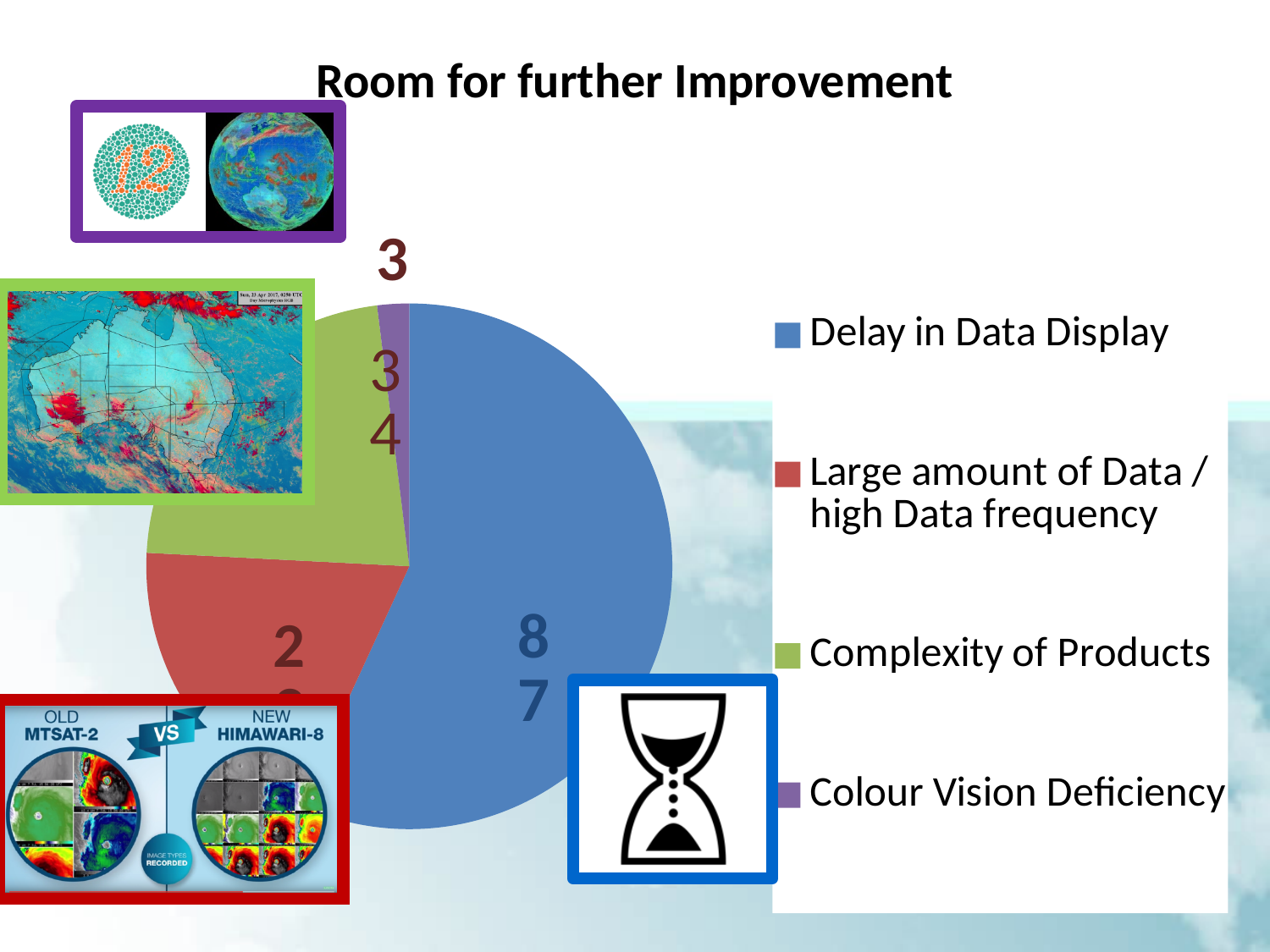
What is the difference between the values for Delay in Data Display and Complexity of Products? 53 Which category has the smallest slice of the pie chart? Colour Vision Deficiency What is the title of the slide containing the pie chart? Room for further Improvement What colour is the slice for Complexity of Products? green What is the value shown for Complexity of Products? 34 What kind of chart is shown on the slide? pie chart Which category has the largest slice of the pie chart? Delay in Data Display What is the value shown for Colour Vision Deficiency? 3 How many slices does the pie chart have? 4 What is the value shown for Delay in Data Display? 87 How many entries does the legend of the pie chart list? 4 Which is larger, Delay in Data Display or Complexity of Products? Delay in Data Display